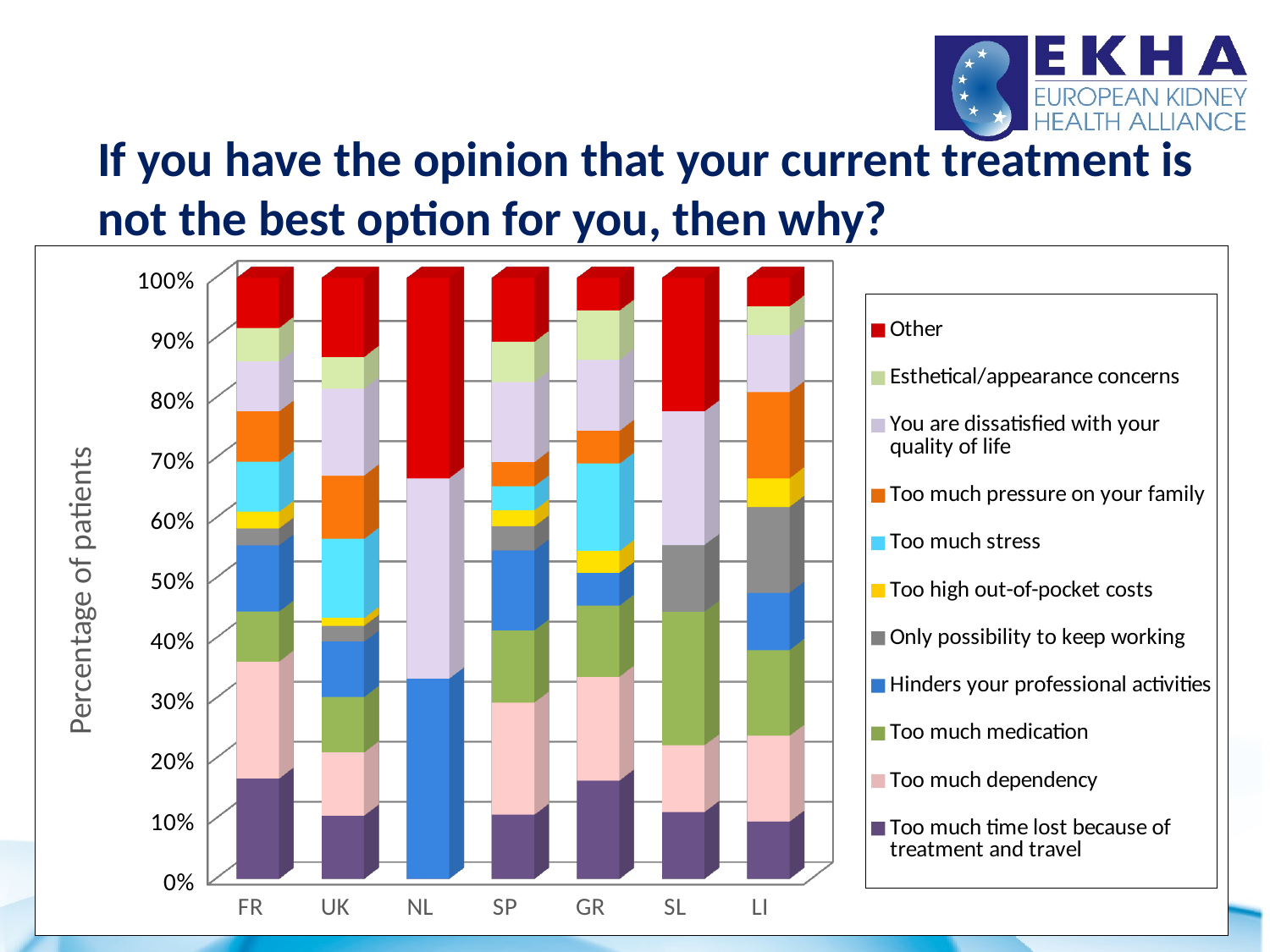
What kind of chart is shown on the slide? Stacked bar chart Is the value for 'Hinders your professional activities' for NL greater or less than 20%? greater Is the value for 'Too much pressure on your family' for LI greater or less than 10%? greater Is the value for 'Too much time lost because of treatment and travel' for FR greater or less than 10%? greater What is the label of the vertical axis of the chart? Percentage of patients How many countries are shown along the x axis of the chart? 7 Which country has the largest share for 'Other'? NL Which is larger, the share for 'Hinders your professional activities' in NL or in FR? NL How many series does the chart's legend list? 11 Which legend entry is shown in red in the chart? Other Which country has the largest share for 'Too much medication'? SL